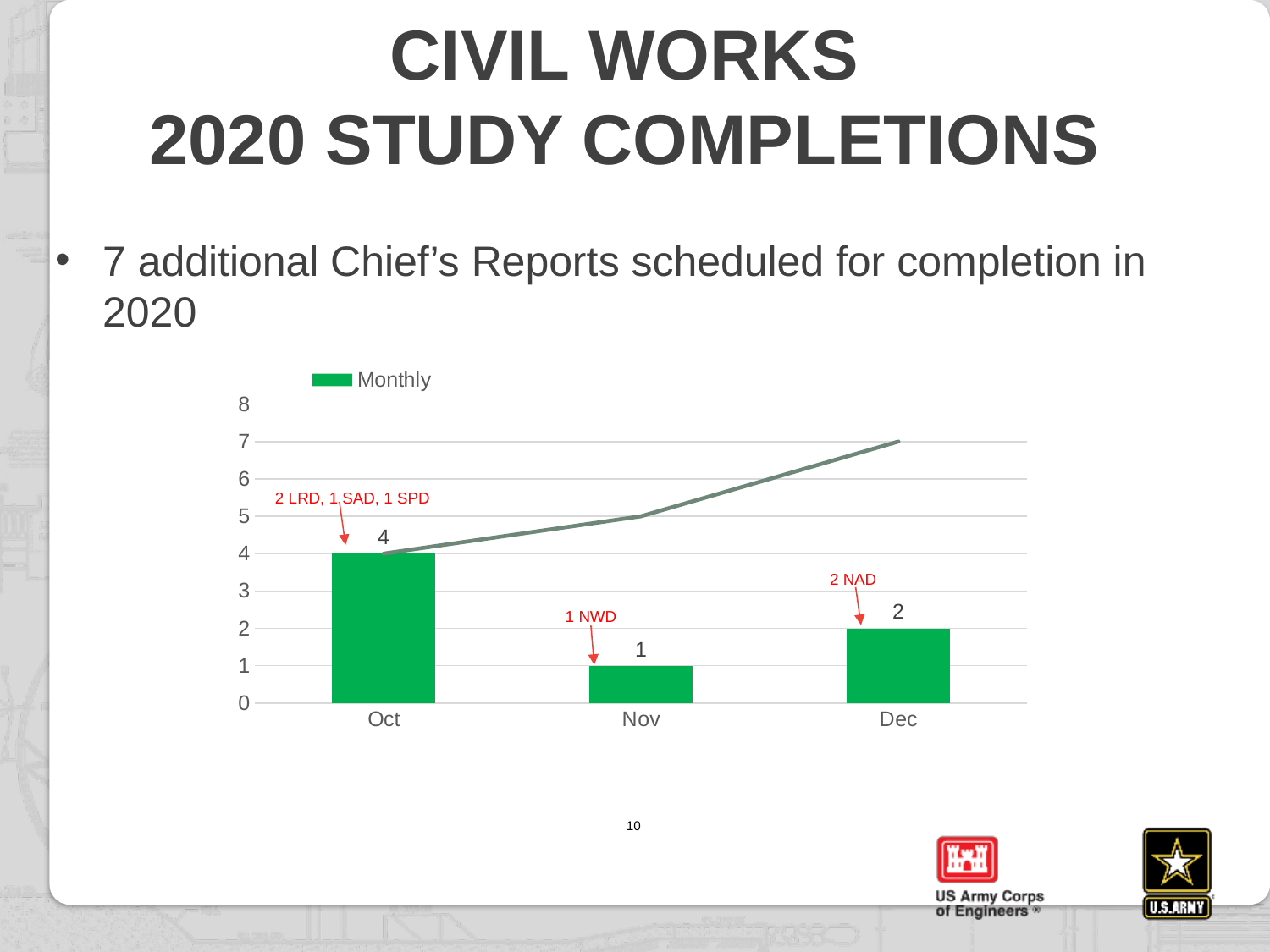
Which is larger, the Monthly value for Nov or for Dec? Dec What is the Monthly value for Nov? 1 What annotation is attached to the Nov bar? 1 NWD What is the Monthly value for Dec? 2 Which month has the lowest Monthly value? Nov What is the Monthly value for Oct? 4 Which month has the highest Monthly value? Oct How many months are shown on the x axis? 3 How many series does the legend list? 1 What is the difference between the Monthly values for Oct and Dec? 2 Is the value of the line at Dec greater or less than 6? greater What kind of chart is used for the Monthly series? bar chart